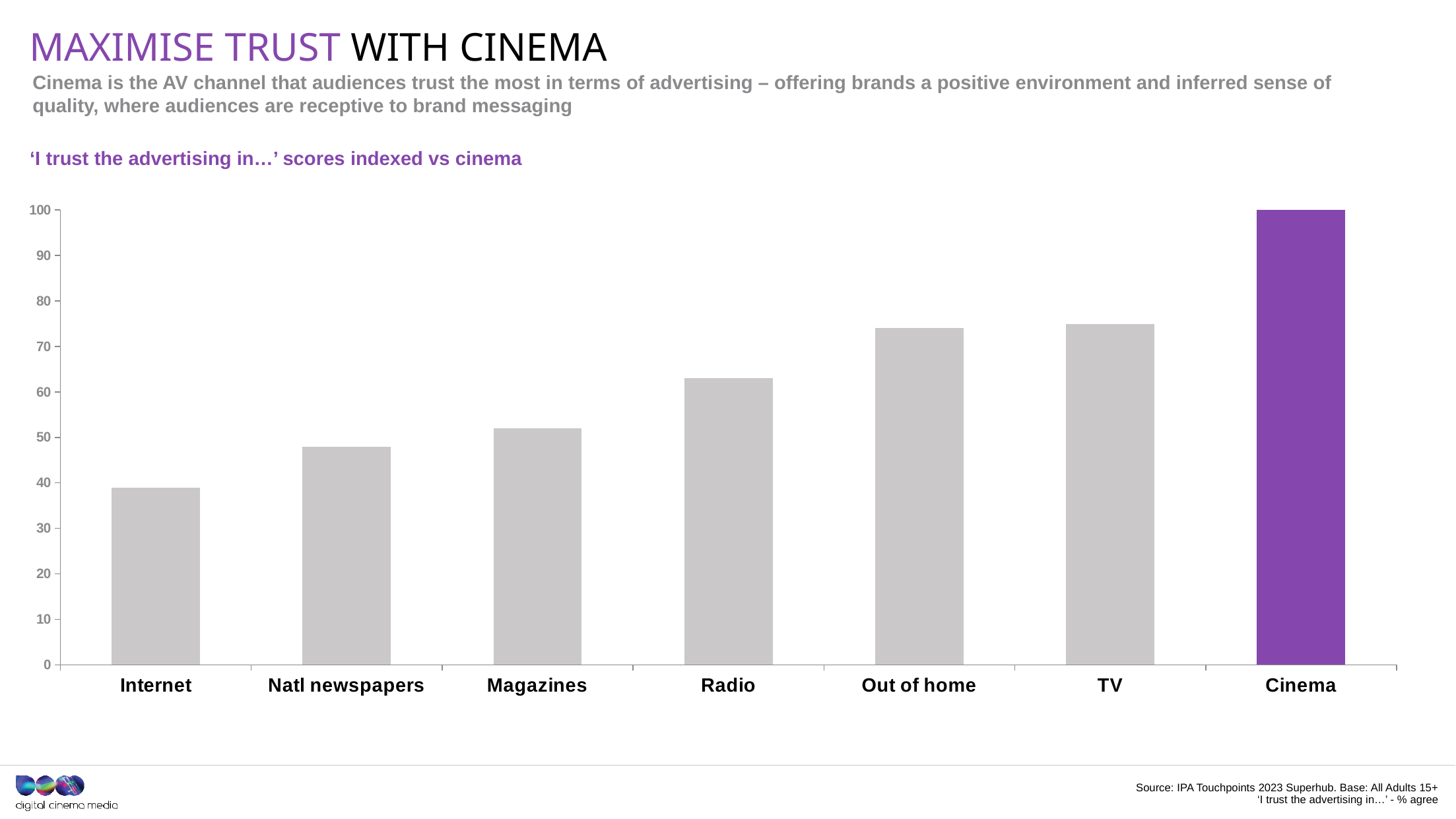
Is the value for TV greater or less than 70? greater Is the value for Natl newspapers greater or less than 50? less Which category has the lowest value? Internet What is the value for Cinema? 100 Which is larger, the value for Internet or the value for Out of home? Out of home Is the value for Radio greater or less than 60? greater Which category has the highest value? Cinema What kind of chart is shown on the slide? bar chart Which is larger, the value for Magazines or the value for Radio? Radio How many categories are shown on the chart? 7 Do the values generally rise or fall from left to right across the categories? rise